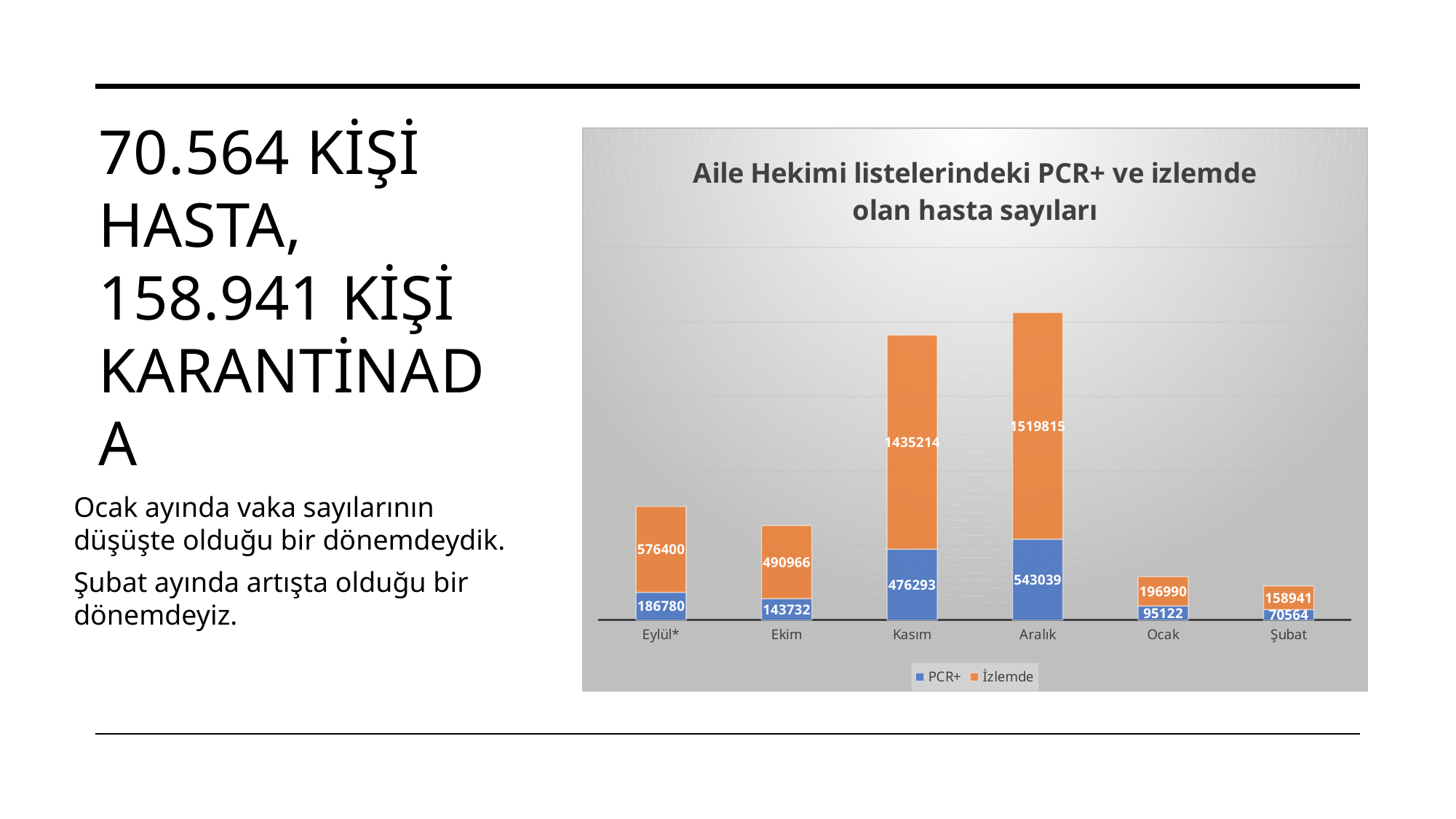
What type of chart is shown on the slide? stacked bar chart What is the difference between the PCR+ values for Aralık and Kasım? 66746 Is the İzlemde value for Eylül* larger or smaller than the İzlemde value for Ekim? larger What is the PCR+ value for Şubat? 70564 How many series does the legend list? 2 What is the İzlemde value for Ekim? 490966 What is the title of the chart? Aile Hekimi listelerindeki PCR+ ve izlemde olan hasta sayıları What is the total of the stacked bar for Şubat? 229505 What is the PCR+ value for Aralık? 543039 How many months are shown on the x axis? 6 Which month has the highest İzlemde value? Aralık Which month has the lowest PCR+ value? Şubat